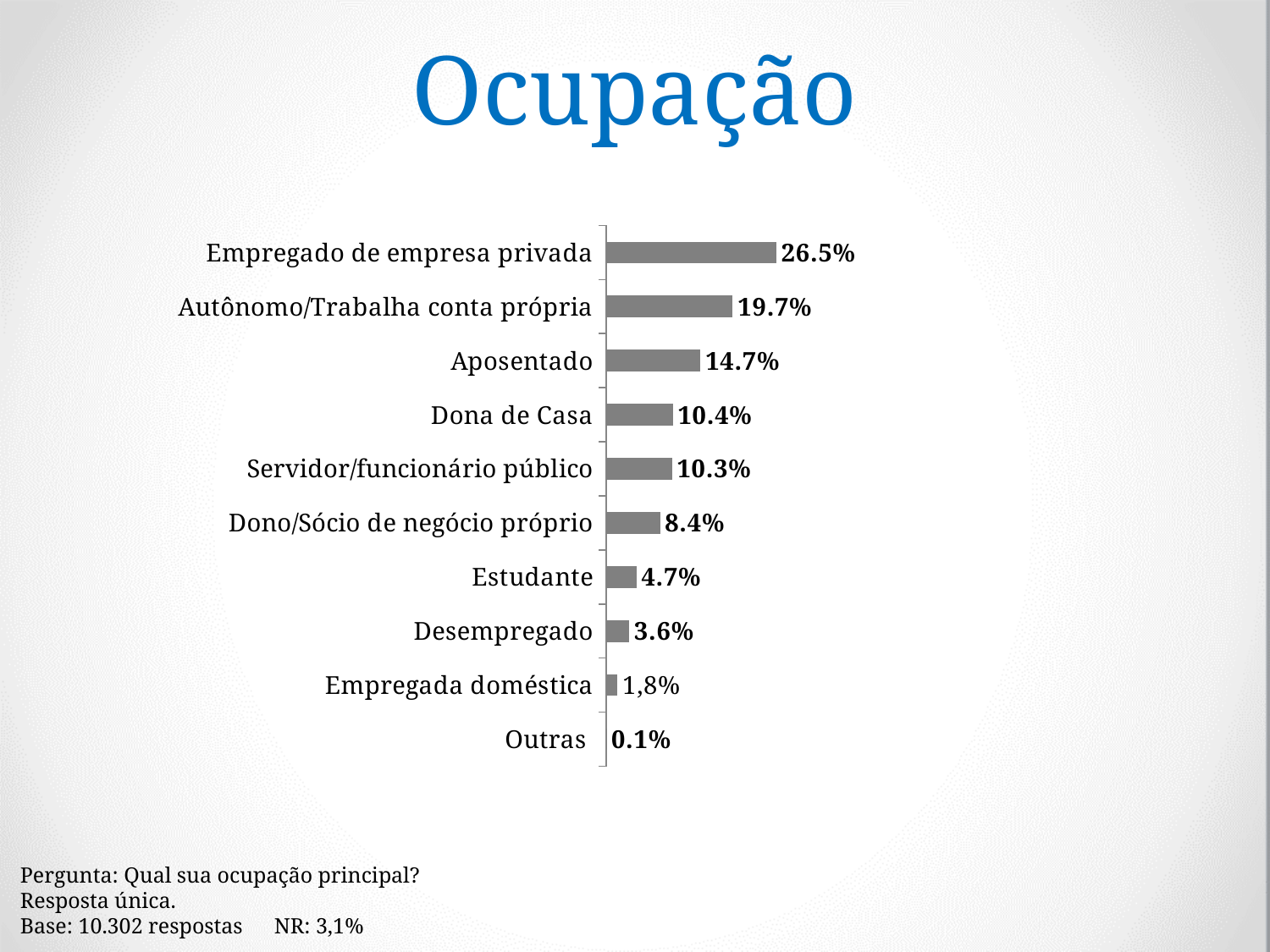
What is the title of the slide? Ocupação What is the value for Aposentado? 14.7% What is the value for Empregada doméstica? 1,8% How many occupation categories are plotted in the chart? 10 What is the difference between Empregado de empresa privada and Autônomo/Trabalha conta própria? 6.8% Which category has the lowest value? Outras What kind of chart is shown on the slide? bar chart What is the value for Empregado de empresa privada? 26.5% What is the value for Estudante? 4.7% What is the difference between Aposentado and Dona de Casa? 4.3% Which category has the highest value? Empregado de empresa privada Which is larger, the value for Estudante or the value for Desempregado? Estudante